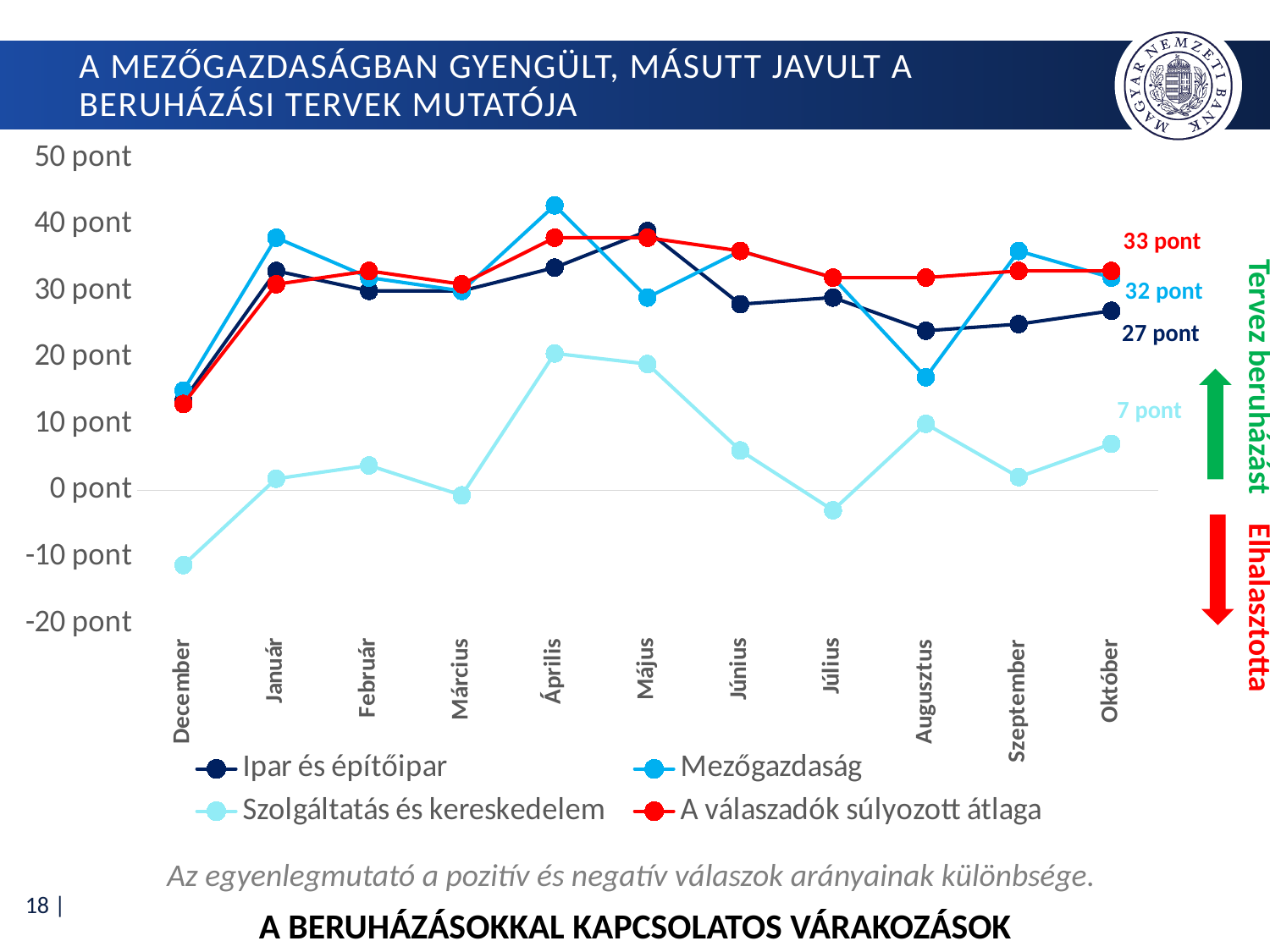
Is the value for Mezőgazdaság in Április greater or less than 40 pont? greater What kind of chart is shown on the slide? line chart What is the value for Ipar és építőipar in Október? 27 pont Which series has the lowest value in Október? Szolgáltatás és kereskedelem What is the value for A válaszadók súlyozott átlaga in Október? 33 pont In Október, what is the difference between A válaszadók súlyozott átlaga and Ipar és építőipar? 6 pont What is the value for Szolgáltatás és kereskedelem in Október? 7 pont In Október, which is higher: Mezőgazdaság or Ipar és építőipar? Mezőgazdaság How many months are shown along the x axis? 11 What is the value for Mezőgazdaság in Október? 32 pont How many series does the legend list? 4 Is the value for Szolgáltatás és kereskedelem in December greater or less than 0 pont? less